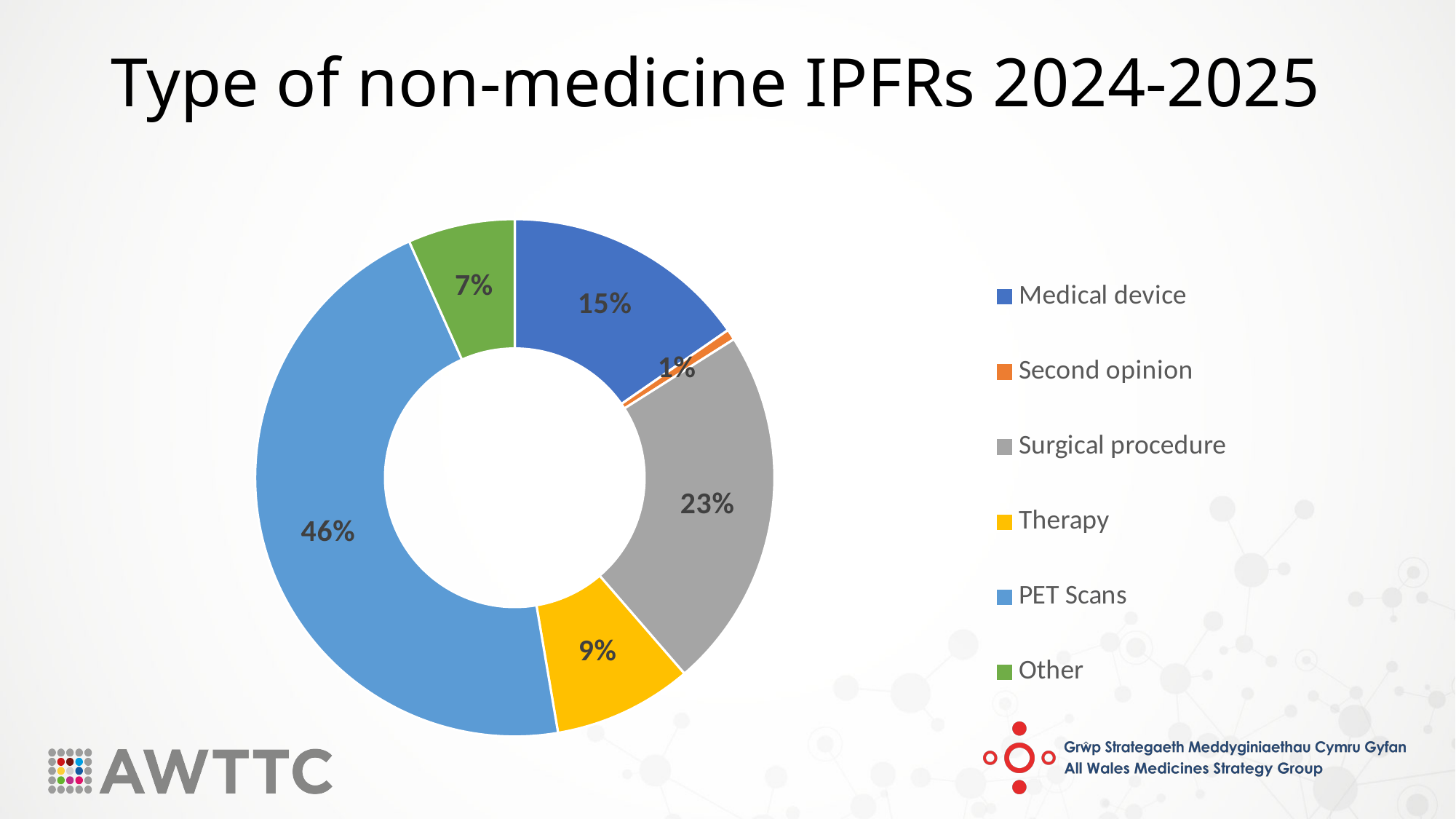
What percentage is shown for Surgical procedure? 23% What is the title of the chart? Type of non-medicine IPFRs 2024-2025 What percentage is shown for Second opinion? 1% Which category has the smallest share of the chart? Second opinion What percentage is shown for Therapy? 9% What is the difference in percentage points between PET Scans and Surgical procedure? 23 What share of non-medicine IPFRs were PET Scans? 46% What kind of chart is shown on the slide? Doughnut (pie) chart Which category has the largest share of the chart? PET Scans How many categories does the legend list? 6 What percentage is shown for Medical device? 15% Which is larger, the share for Medical device or the share for Therapy? Medical device